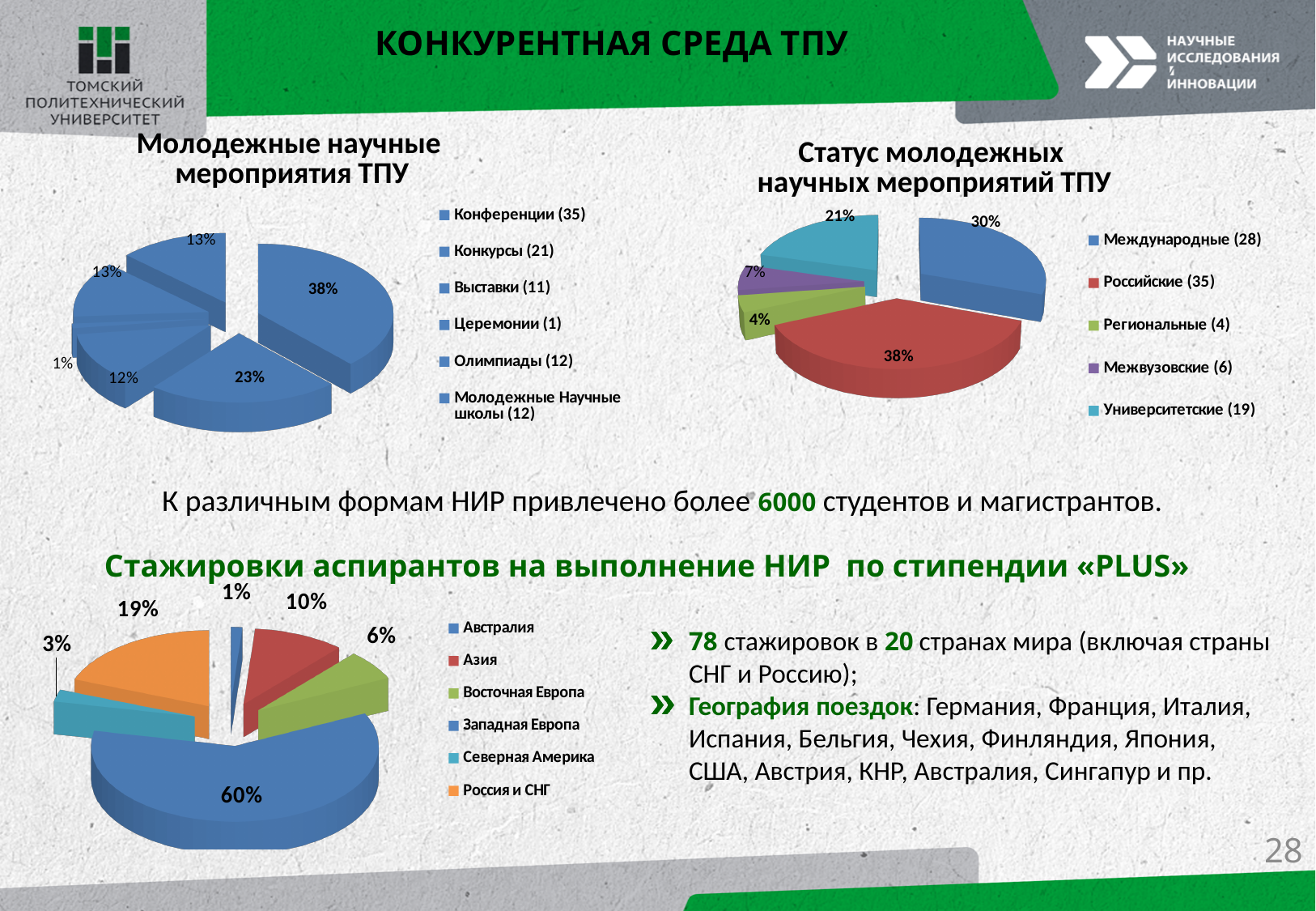
In the chart 'Статус молодежных научных мероприятий ТПУ', what share of the pie is Российские? 38% In the chart 'Молодежные научные мероприятия ТПУ', how many categories does the legend list? 6 In the chart 'Статус молодежных научных мероприятий ТПУ', how many categories does the legend list? 5 What type of chart is 'Молодежные научные мероприятия ТПУ'? Pie chart In the chart 'Молодежные научные мероприятия ТПУ', what is the largest percentage shown on the pie? 38% In the chart 'Стажировки аспирантов на выполнение НИР по стипендии «PLUS»', what share of the pie is Россия и СНГ? 19% In the chart 'Стажировки аспирантов на выполнение НИР по стипендии «PLUS»', which is larger, Азия or Восточная Европа? Азия In the chart 'Стажировки аспирантов на выполнение НИР по стипендии «PLUS»', what share of the pie is Западная Европа? 60% In the chart 'Статус молодежных научных мероприятий ТПУ', what is the difference in percentage points between Российские and Международные? 8 In the chart 'Стажировки аспирантов на выполнение НИР по стипендии «PLUS»', which category has the smallest slice? Австралия In the chart 'Статус молодежных научных мероприятий ТПУ', which category has the smallest slice? Региональные